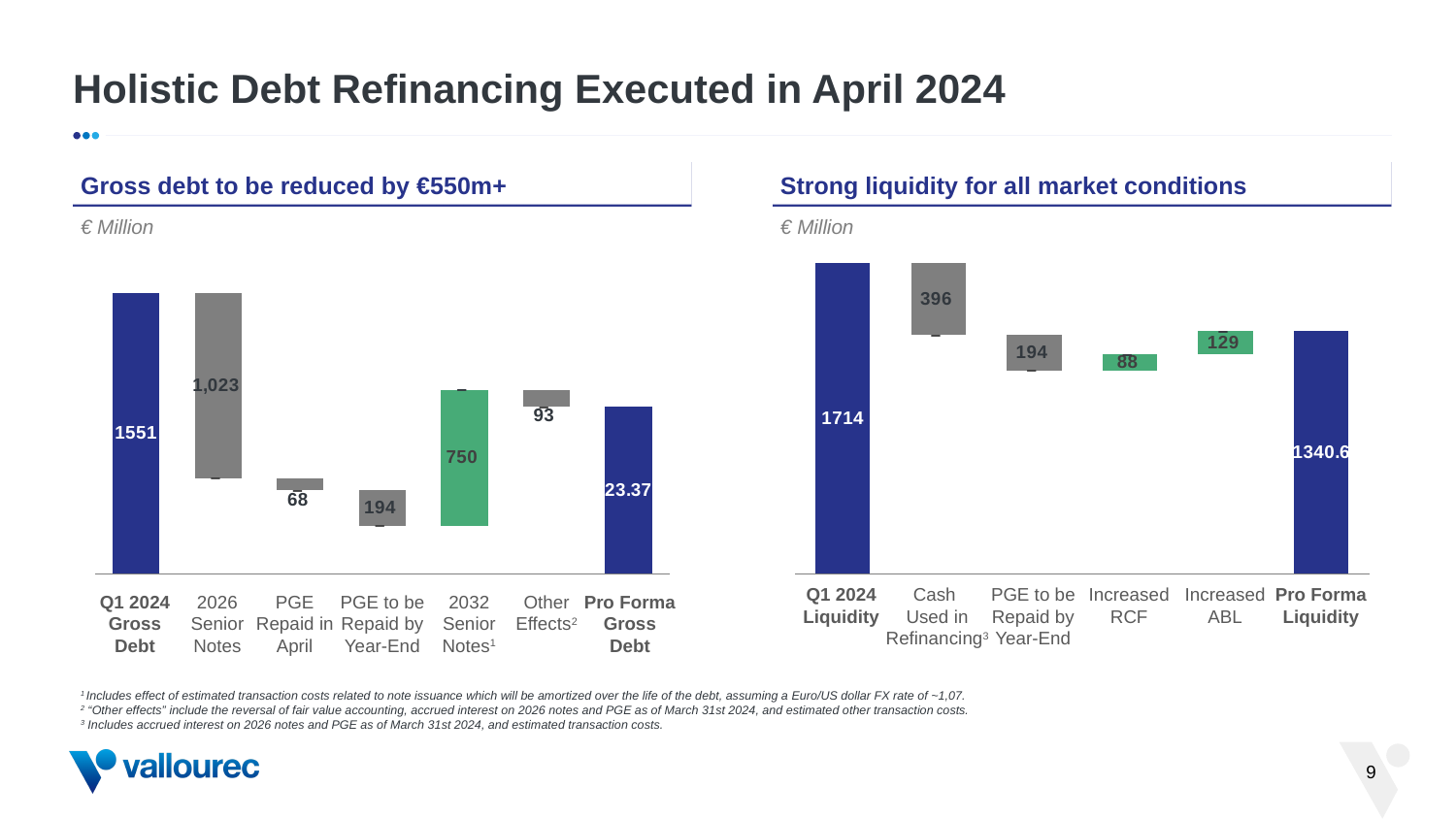
What unit is stated for the values in both charts on the slide? € Million In the 'Strong liquidity for all market conditions' chart, what is the value for Pro Forma Liquidity? 1340.6 In the 'Gross debt to be reduced by €550m+' chart, what is the value for 2026 Senior Notes? 1,023 In the 'Gross debt to be reduced by €550m+' chart, what is the value for 2032 Senior Notes? 750 In the 'Gross debt to be reduced by €550m+' chart, how many categories are shown on the x axis? 7 In the 'Gross debt to be reduced by €550m+' chart, which of PGE Repaid in April or PGE to be Repaid by Year-End has the larger value? PGE to be Repaid by Year-End In the 'Strong liquidity for all market conditions' chart, which category has the smallest value? Increased RCF In the 'Strong liquidity for all market conditions' chart, what is the value for Cash Used in Refinancing? 396 In the 'Gross debt to be reduced by €550m+' chart, what is the value for Q1 2024 Gross Debt? 1551 In the 'Strong liquidity for all market conditions' chart, what is the value for Q1 2024 Liquidity? 1714 In the 'Strong liquidity for all market conditions' chart, what is the difference between the Increased ABL value and the Increased RCF value? 41 In the 'Gross debt to be reduced by €550m+' chart, what is the value for Other Effects? 93